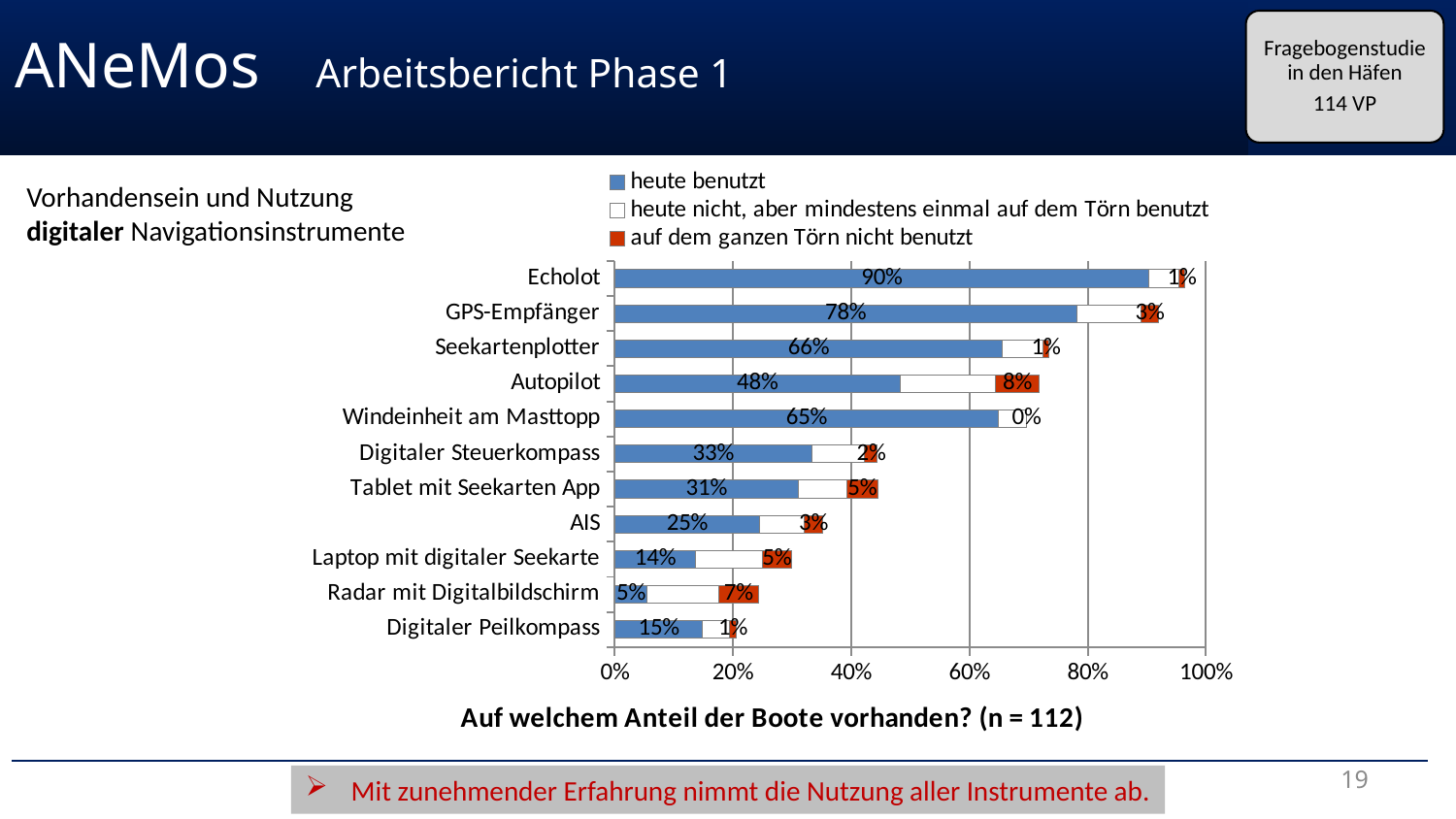
Which has a higher 'heute benutzt' value, Autopilot or Windeinheit am Masttopp? Windeinheit am Masttopp What kind of chart is shown on the slide? Stacked bar chart What is the 'heute benutzt' value for Autopilot? 48% Which instrument has the highest 'heute benutzt' percentage? Echolot What is the difference in 'heute benutzt' percentage between Echolot and GPS-Empfänger? 12% What is the 'auf dem ganzen Törn nicht benutzt' value for Radar mit Digitalbildschirm? 7% Which instrument has the highest 'auf dem ganzen Törn nicht benutzt' percentage? Autopilot Which instrument has the lowest 'heute benutzt' percentage? Radar mit Digitalbildschirm What percentage is shown for 'heute benutzt' for Echolot? 90% Is the total bar length for Echolot greater or less than 80%? greater How many instruments (categories) are shown in the chart? 11 How many series does the legend list? 3